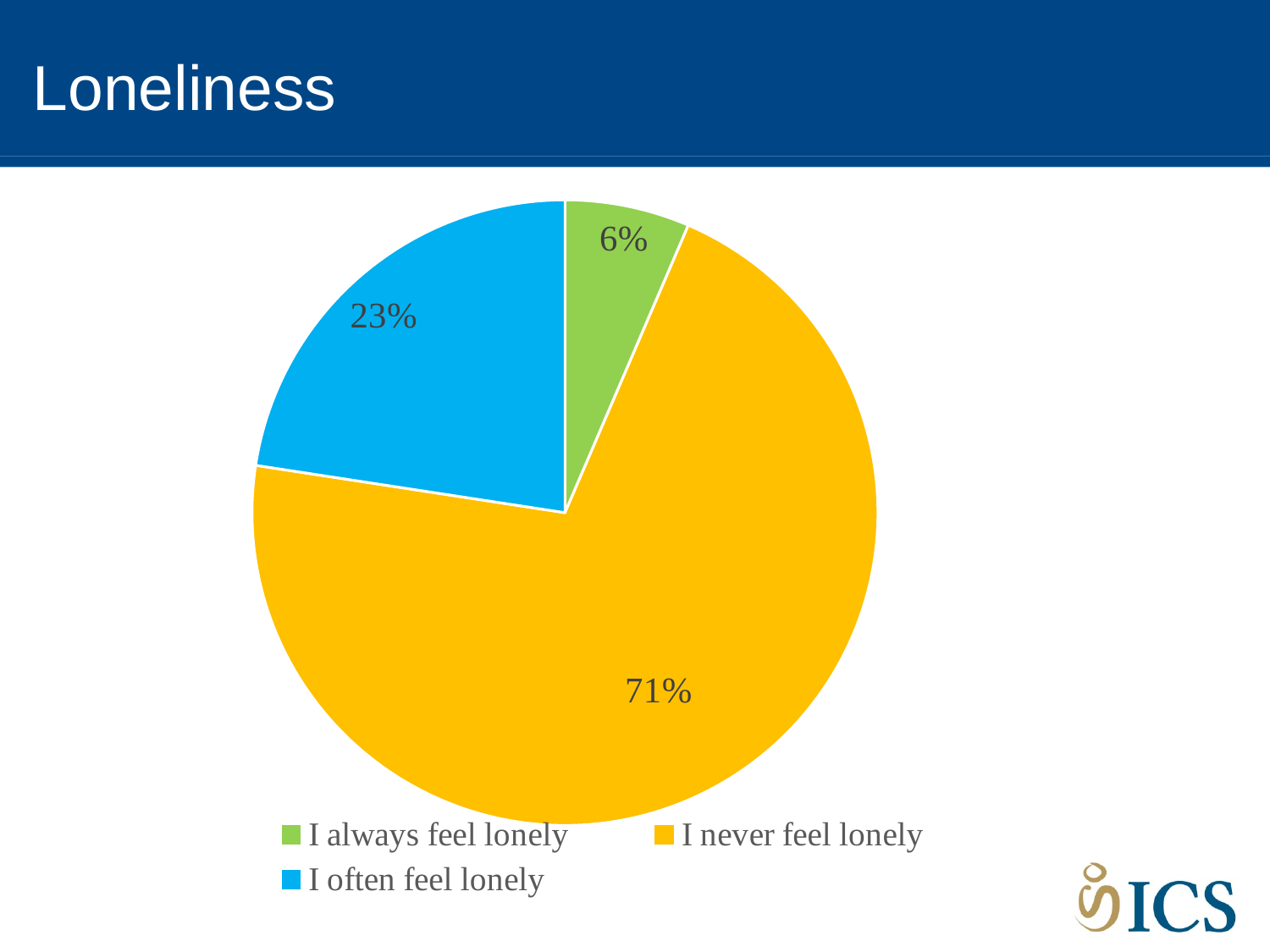
What percentage of respondents said "I often feel lonely"? 23% Which response has the smallest share of the pie? I always feel lonely How many entries does the legend list? 3 What kind of chart is shown on the slide? pie chart What colour is the slice for "I often feel lonely"? blue How many slices does the pie chart have? 3 What is the difference in percentage points between "I never feel lonely" and "I often feel lonely"? 48 What percentage of respondents said "I never feel lonely"? 71% What percentage of respondents said "I always feel lonely"? 6% Which response has the largest share of the pie? I never feel lonely What is the difference in percentage points between "I often feel lonely" and "I always feel lonely"? 17 Which is larger: the share for "I often feel lonely" or the share for "I always feel lonely"? I often feel lonely